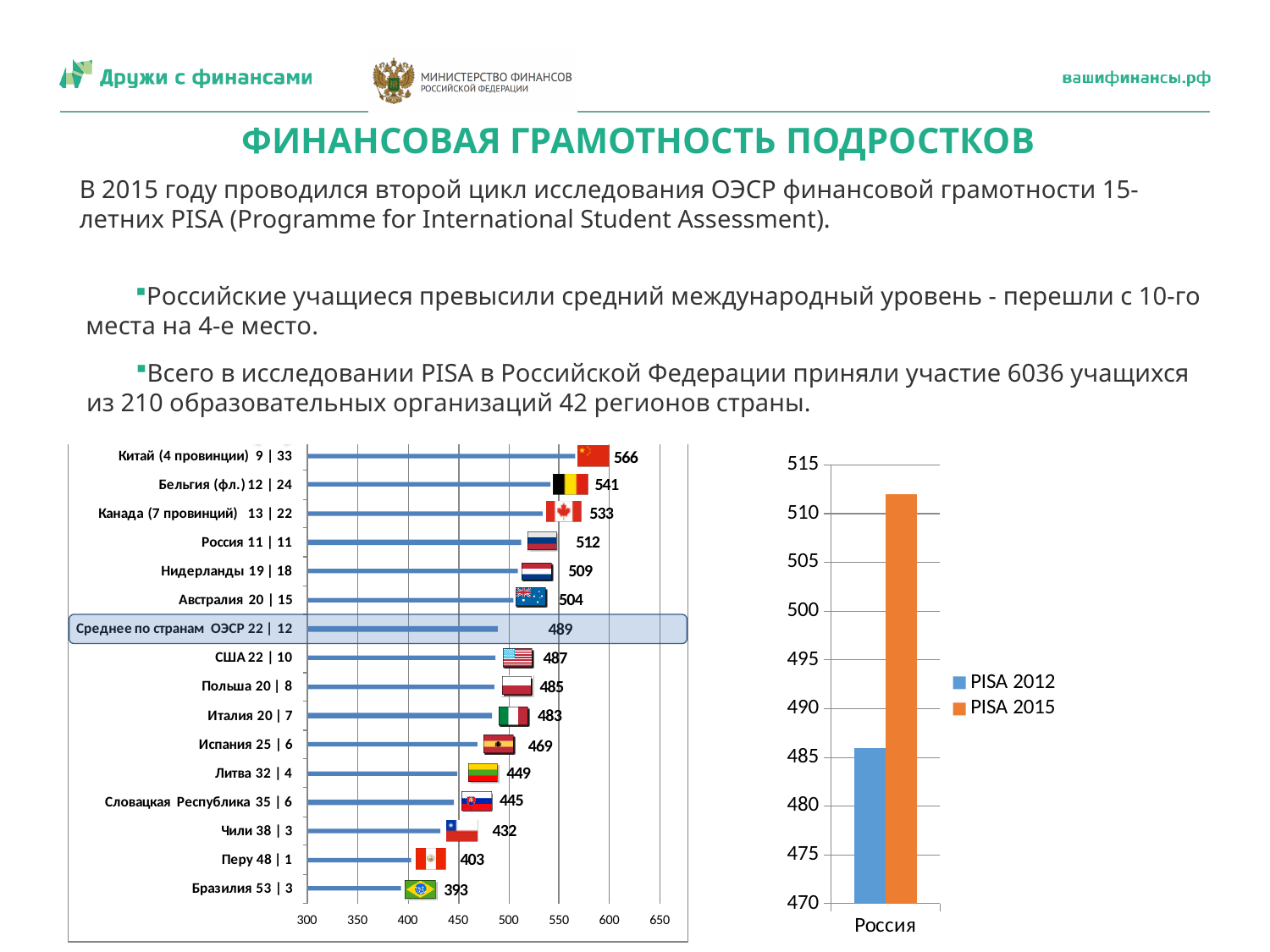
In the right chart, is the value for PISA 2012 for Россия greater or less than 490? less In the right chart, which is larger for Россия, PISA 2012 or PISA 2015? PISA 2015 How many series does the legend of the right chart list? 2 In the left chart, what is the difference between the values for Россия and Среднее по странам ОЭСР? 23 In the left chart, which is larger, the value for Нидерланды or the value for Австралия? Нидерланды In the left chart, which category has the highest value? Китай (4 провинции) In the left chart, what is the value for Среднее по странам ОЭСР? 489 In the left chart, what is the value for Китай (4 провинции)? 566 How many categories are shown in the left chart? 16 In the left chart, which category has the lowest value? Бразилия What kind of chart is the left chart? bar chart In the left chart, what is the value for Россия? 512